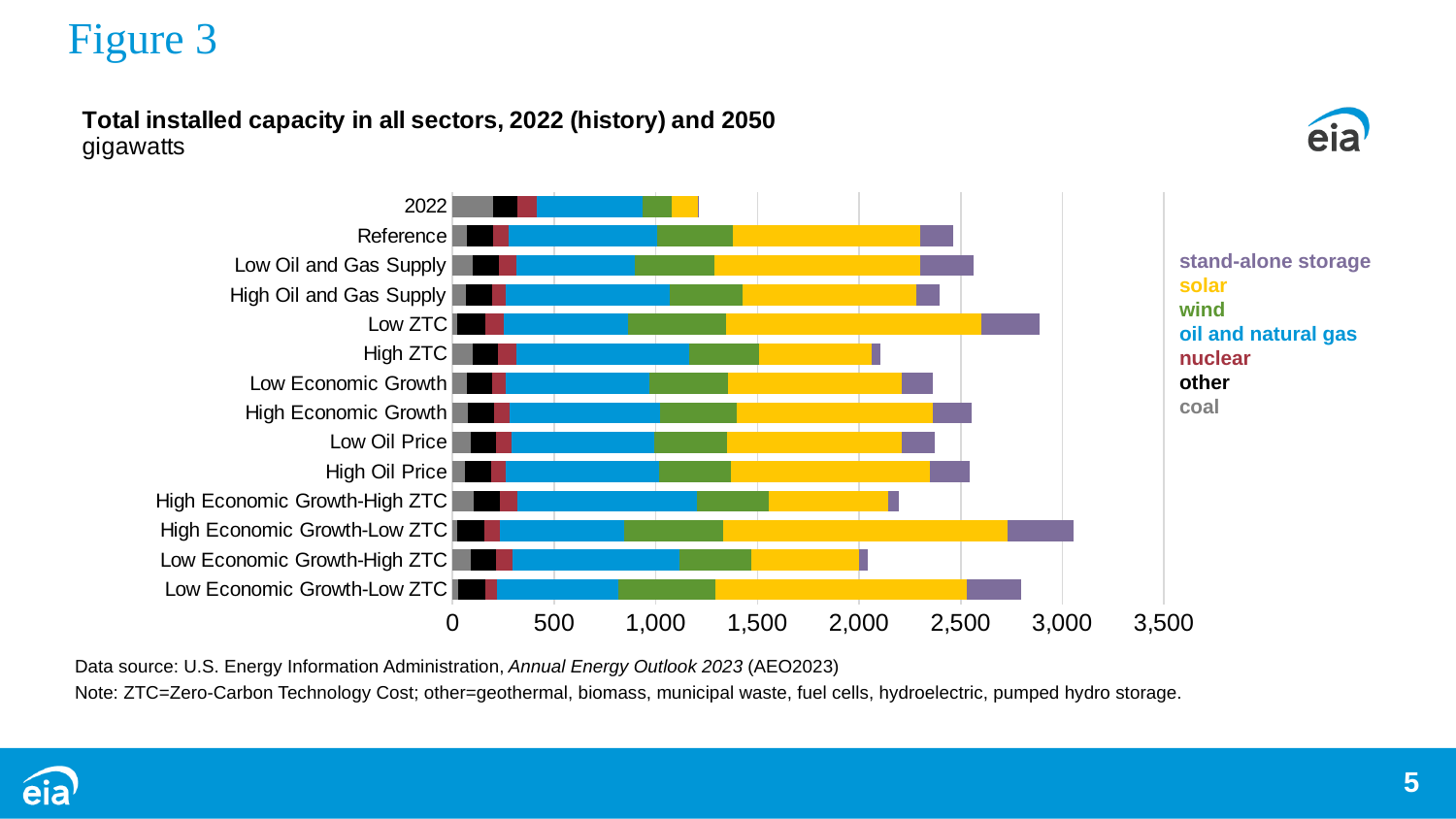
Which series is shown in yellow in the chart? solar How many bars (cases) are plotted on the chart? 14 Is the total installed capacity for High ZTC greater or less than 2,500 gigawatts? less What unit is the chart measured in, according to the subtitle? gigawatts How many series does the legend list? 7 Which has the larger total installed capacity, 2022 or Reference? Reference Which case has the highest total installed capacity? High Economic Growth-Low ZTC Is the total installed capacity for Low ZTC greater or less than 2,500 gigawatts? greater Is the total installed capacity for 2022 greater or less than 1,500 gigawatts? less Which has the larger total installed capacity, Low ZTC or High ZTC? Low ZTC Which bar has the lowest total installed capacity? 2022 What kind of chart is shown on the slide? stacked bar chart